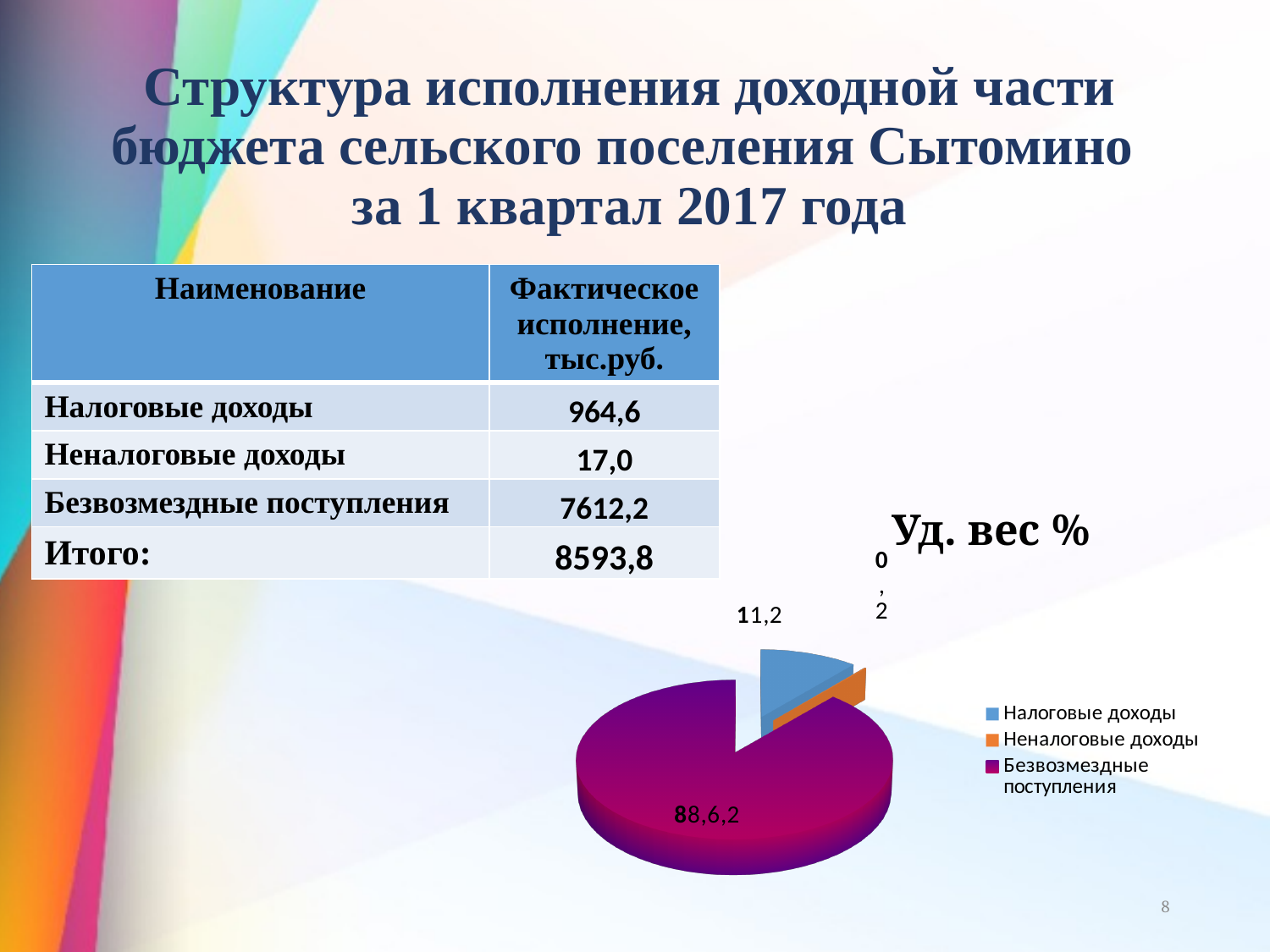
How many entries does the legend of the pie chart list? 3 Which category has the largest slice in the pie chart? Безвозмездные поступления What colour is the Безвозмездные поступления slice in the pie chart? purple Which category has the smallest slice in the pie chart? Неналоговые доходы Which slice is larger in the pie chart: Налоговые доходы or Неналоговые доходы? Налоговые доходы What value is labelled on the Налоговые доходы slice of the pie chart? 11,2 How many slices does the pie chart have? 3 What is the title of the pie chart? Уд. вес % What kind of chart is shown on the slide? pie chart Which slice is larger in the pie chart: Безвозмездные поступления or Налоговые доходы? Безвозмездные поступления